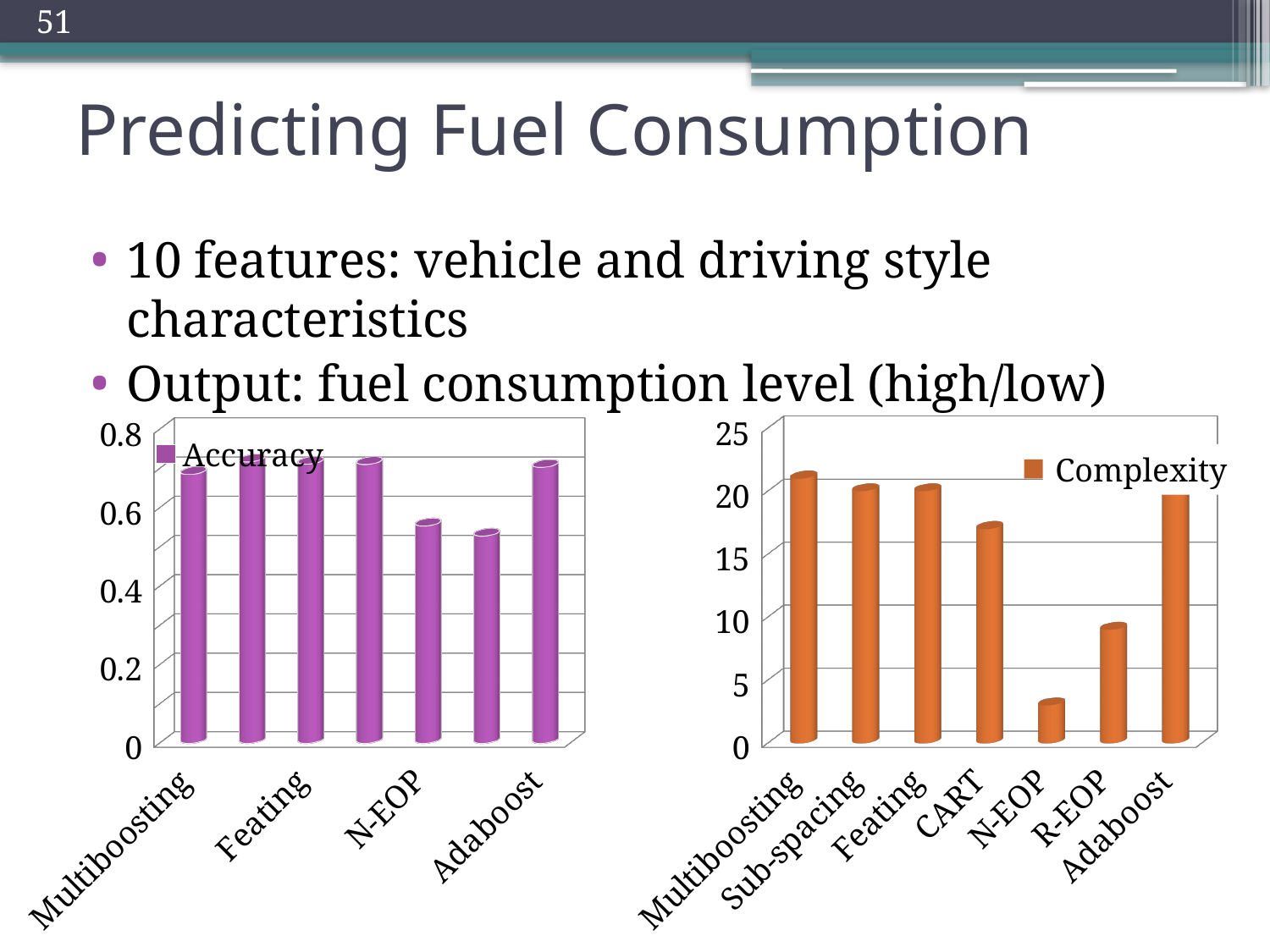
In the Accuracy chart, is the value for Multiboosting greater or less than 0.6? greater What is the legend entry of the chart on the right? Complexity In the Complexity chart, is the value for CART greater or less than 15? greater In the Complexity chart, is the value for N-EOP greater or less than 5? less In the Accuracy chart, which has the higher accuracy, Feating or N-EOP? Feating In the Complexity chart, which category has the lowest complexity? N-EOP What kind of chart is the Accuracy chart on the left? bar chart How many bars are plotted in the Complexity chart on the right? 7 In the Complexity chart, which has the higher complexity, CART or R-EOP? CART How many series does the legend of the Accuracy chart list? 1